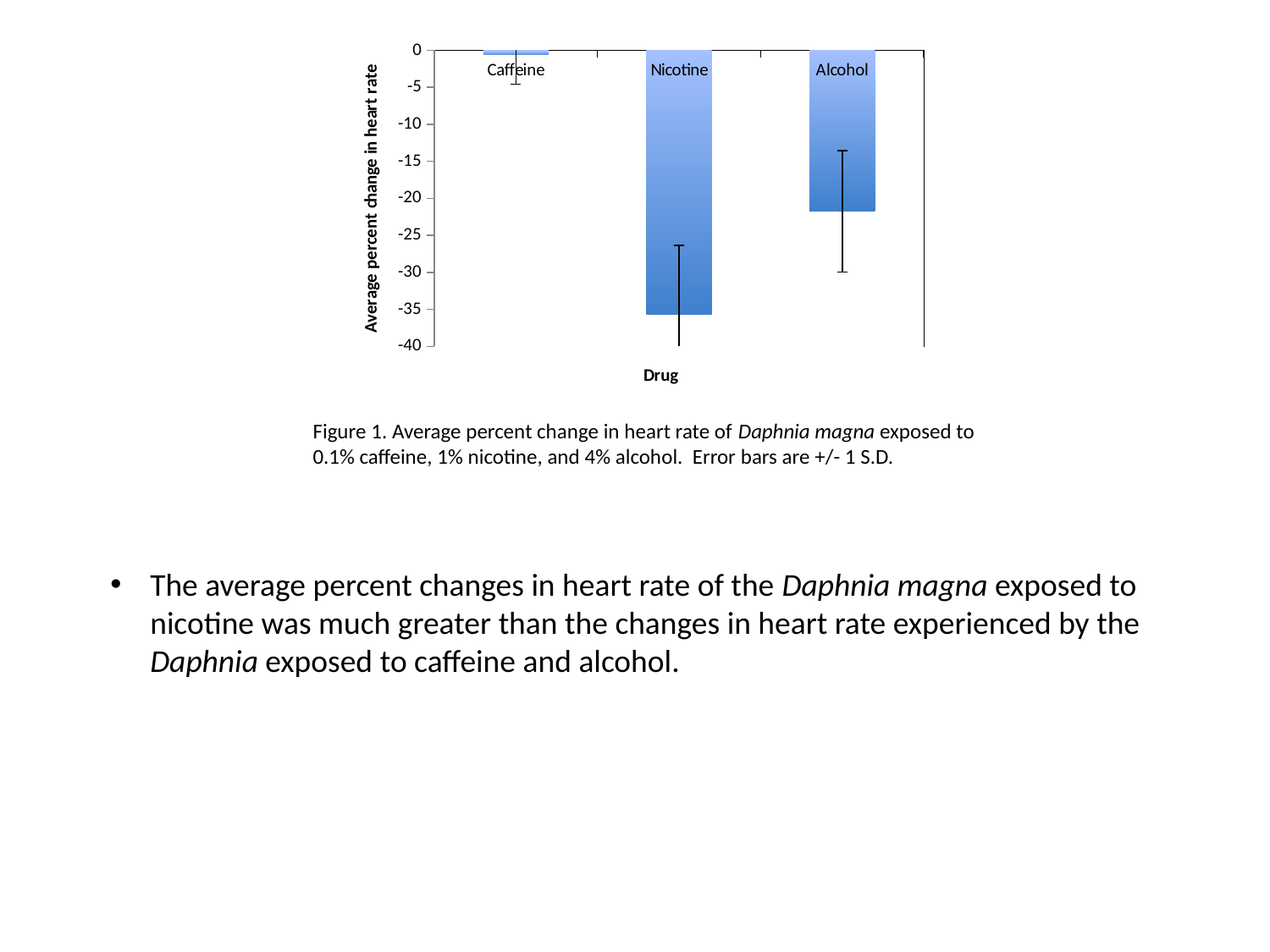
Which drug has the average percent change in heart rate closest to zero? Caffeine What is the title of the x axis of the chart? Drug Is the value for Alcohol greater or less than -25? greater Is the value for Alcohol greater or less than -10? less What kind of chart is shown on the slide? bar chart How many drug categories are plotted in the chart? 3 Is the value for Caffeine greater or less than -5? greater Which bar extends further below zero, Caffeine or Alcohol? Alcohol Which drug shows the largest decrease in average percent change in heart rate (the bar extending furthest below zero)? Nicotine Which bar extends further below zero, Nicotine or Alcohol? Nicotine What is the title of the y axis of the chart? Average percent change in heart rate